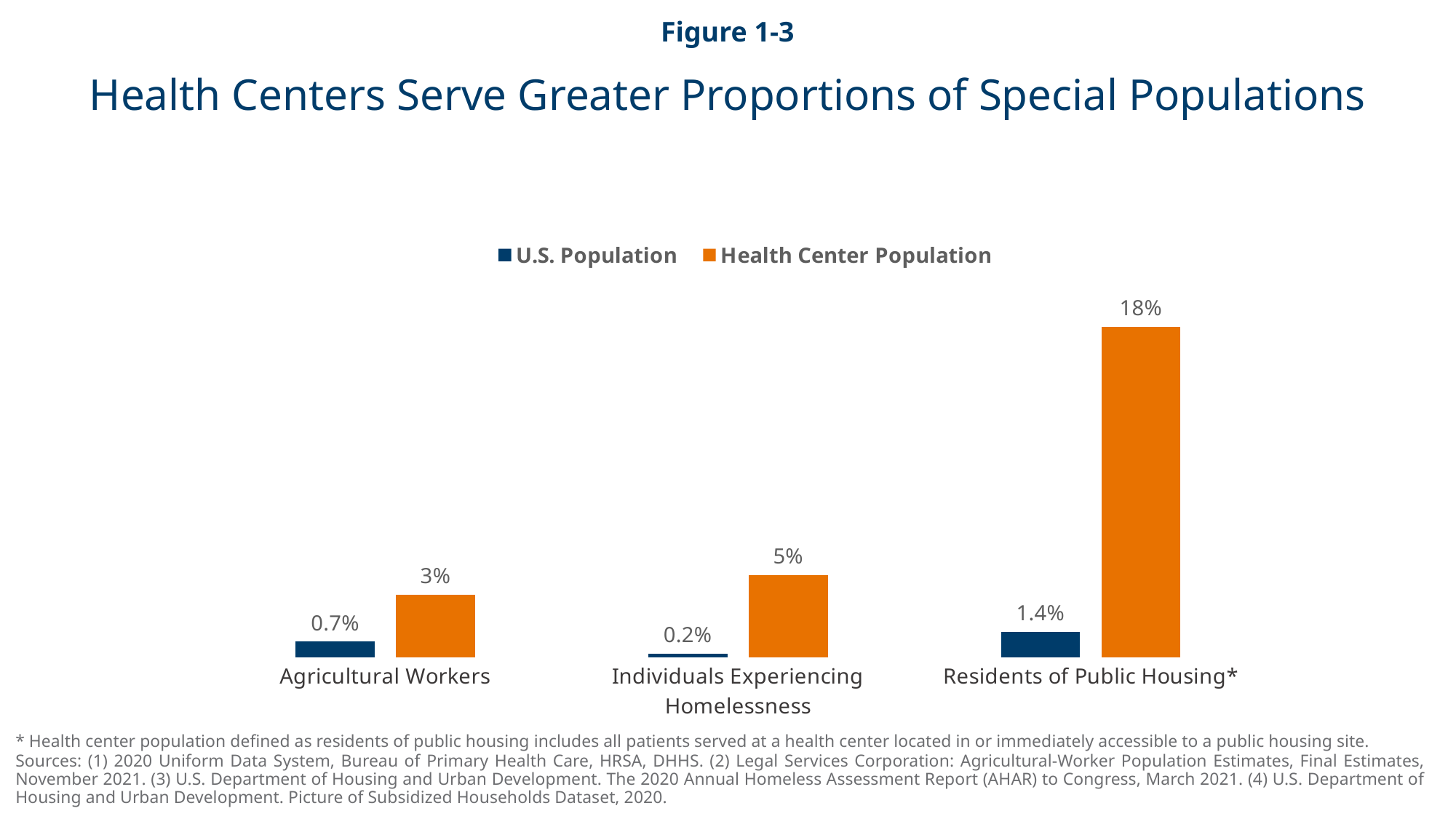
Which is larger for Agricultural Workers: the U.S. Population value or the Health Center Population value? Health Center Population Which category has the lowest U.S. Population value? Individuals Experiencing Homelessness What is the difference between the Health Center Population and U.S. Population values for Agricultural Workers? 2.3% What is the difference between the Health Center Population and U.S. Population values for Residents of Public Housing*? 16.6% How many series does the legend list? 2 What is the Health Center Population value for Individuals Experiencing Homelessness? 5% What is the U.S. Population value for Individuals Experiencing Homelessness? 0.2% How many categories are shown on the x axis? 3 What is the U.S. Population value for Agricultural Workers? 0.7% What is the Health Center Population value for Residents of Public Housing*? 18% What kind of chart is shown on the slide? Bar chart Which category has the highest Health Center Population value? Residents of Public Housing*